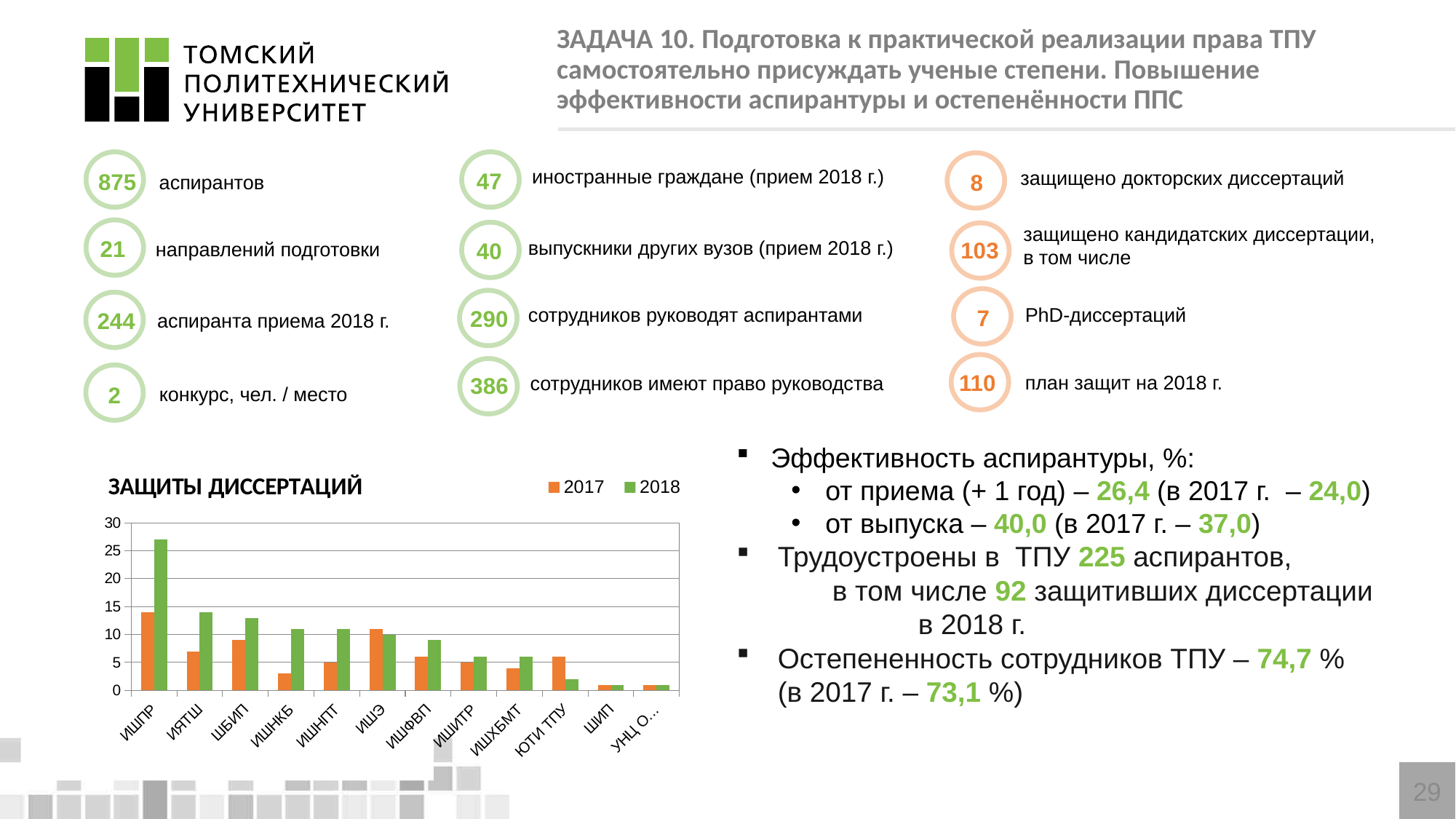
What is the title of the bar chart on the slide? ЗАЩИТЫ ДИССЕРТАЦИЙ What kind of chart is shown under the title "ЗАЩИТЫ ДИССЕРТАЦИЙ"? bar chart In the "ЗАЩИТЫ ДИССЕРТАЦИЙ" chart, which category has the highest value for 2018? ИШПР How many categories are shown on the x axis of the "ЗАЩИТЫ ДИССЕРТАЦИЙ" chart? 12 How many series does the legend of the "ЗАЩИТЫ ДИССЕРТАЦИЙ" chart list? 2 In the "ЗАЩИТЫ ДИССЕРТАЦИЙ" chart, which is larger for ЮТИ ТПУ: the 2017 value or the 2018 value? 2017 In the "ЗАЩИТЫ ДИССЕРТАЦИЙ" chart, which is larger for ИЯТШ: the 2017 value or the 2018 value? 2018 In the "ЗАЩИТЫ ДИССЕРТАЦИЙ" chart, is the 2018 value for ИШПР greater or less than 25? greater In the "ЗАЩИТЫ ДИССЕРТАЦИЙ" chart, what colour represents the 2018 series? green In the "ЗАЩИТЫ ДИССЕРТАЦИЙ" chart, is the 2017 value for ИШНКБ greater or less than 5? less In the "ЗАЩИТЫ ДИССЕРТАЦИЙ" chart, which category has the highest value for 2017? ИШПР In the "ЗАЩИТЫ ДИССЕРТАЦИЙ" chart, is the 2018 value for ШБИП greater or less than 10? greater